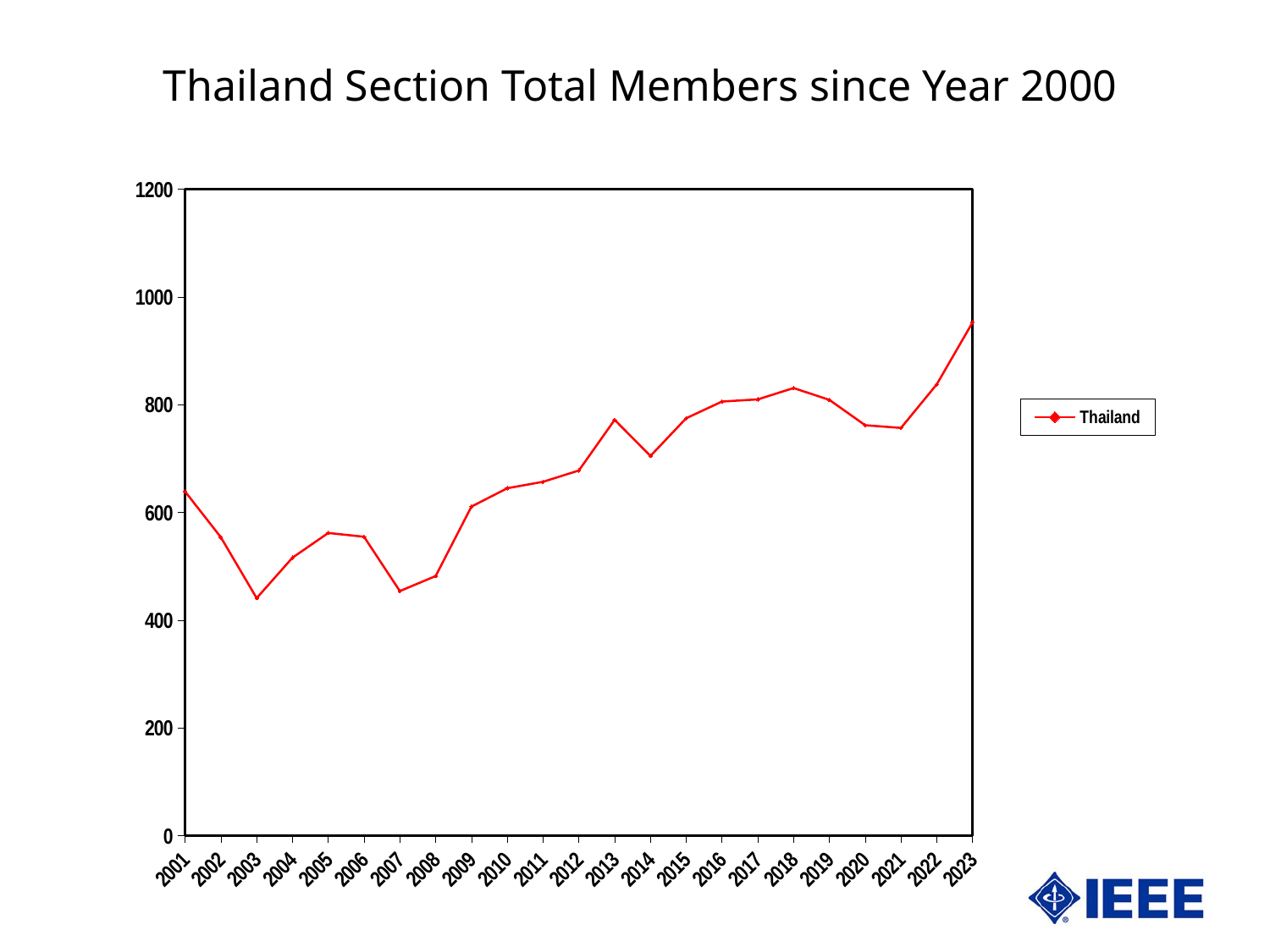
How many series does the legend list? 1 Is the value for 2023 greater or less than 800? greater How many years are plotted along the x axis? 23 Is the value for 2018 greater or less than 800? greater What is the title of the chart? Thailand Section Total Members since Year 2000 Which year has the larger value, 2013 or 2014? 2013 Is the value for 2003 greater or less than 600? less Which year has the highest number of members? 2023 What kind of chart is shown on the slide? line chart Which year has the larger value, 2001 or 2023? 2023 Do the values rise or fall from 2020 to 2023? rise What is the name of the series shown in the legend? Thailand